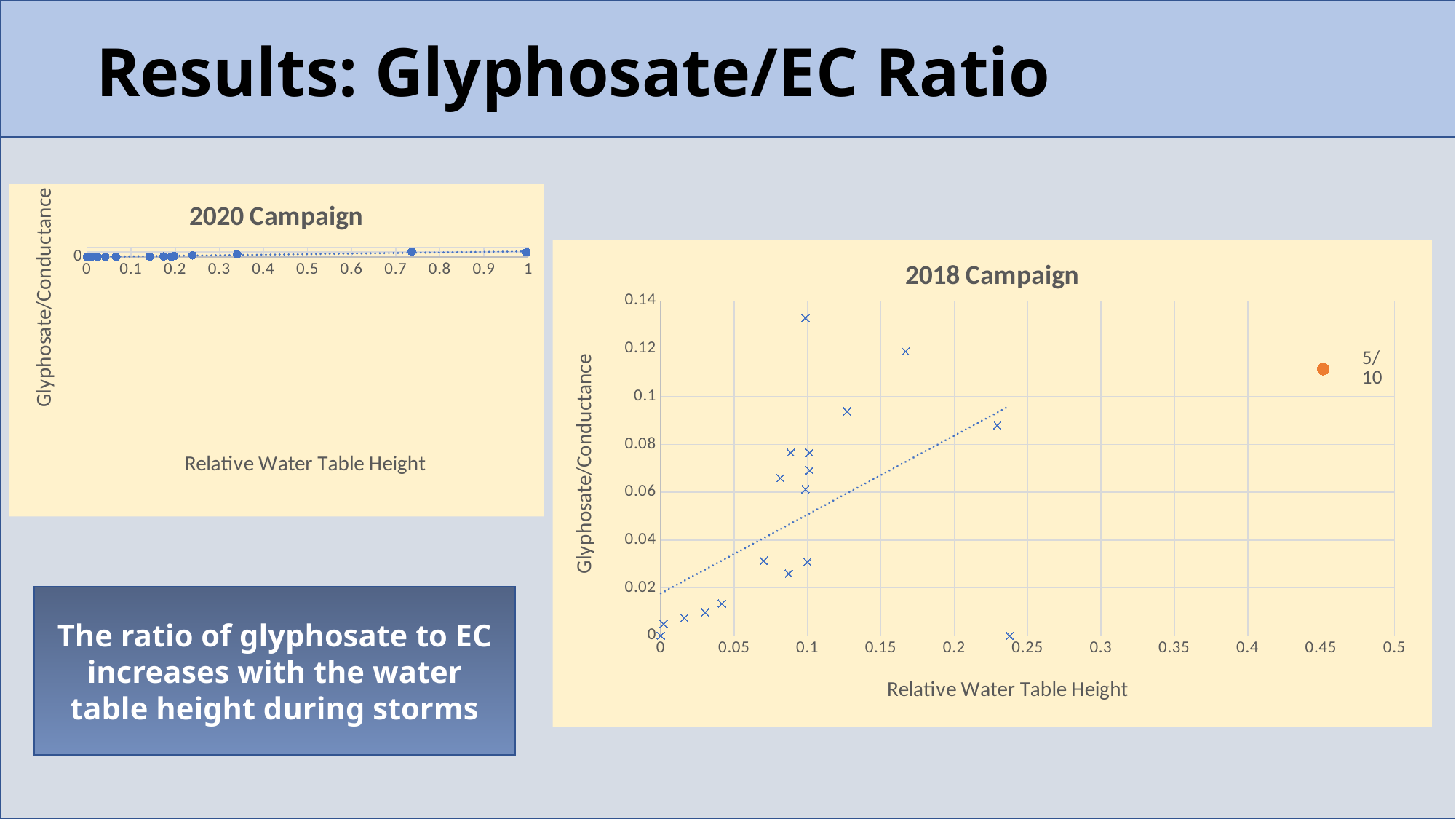
What is the y-axis title of the 2018 Campaign chart? Glyphosate/Conductance What kind of chart is the 2018 Campaign chart? scatter chart What are the titles of the two charts on the slide? 2020 Campaign and 2018 Campaign In the 2018 Campaign chart, is the highest blue data point greater or less than 0.12 on the y axis? greater What is the highest tick value shown on the x axis of the 2020 Campaign chart? 1 What is the highest tick value shown on the y axis of the 2018 Campaign chart? 0.14 What is the x-axis title of the 2018 Campaign chart? Relative Water Table Height In the 2018 Campaign chart, does the dotted trend line rise or fall as Relative Water Table Height increases? rises In the 2018 Campaign chart, is the Glyphosate/Conductance value of the blue point near a Relative Water Table Height of 0.24 greater or less than 0.02? less What is the highest tick value shown on the x axis of the 2018 Campaign chart? 0.5